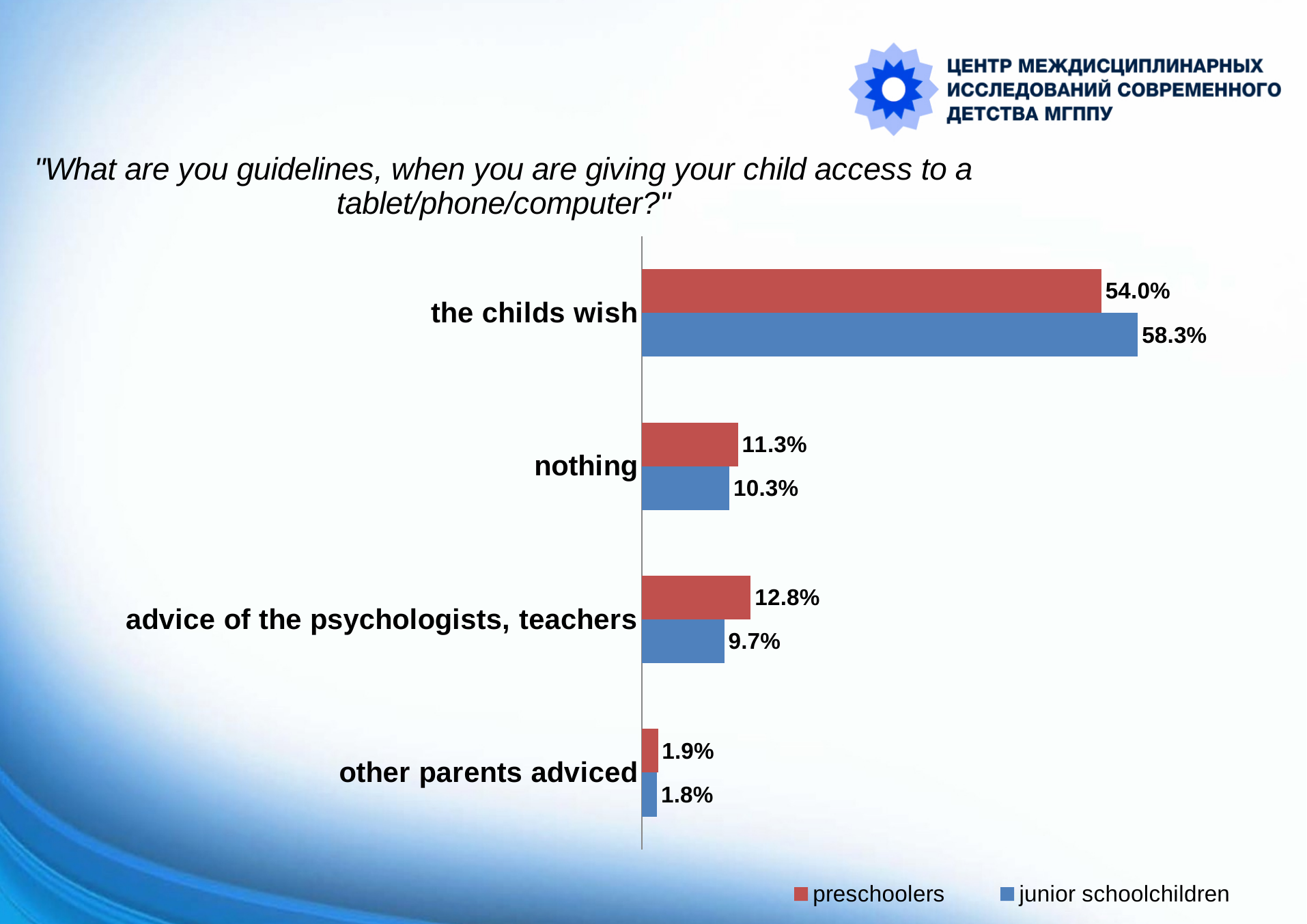
What is the value for junior schoolchildren for "nothing"? 10.3% What is the difference between the junior schoolchildren and preschoolers values for "the childs wish"? 4.3% What kind of chart is shown on the slide? bar chart Which category has the lowest value for preschoolers? other parents adviced What is the difference between the preschoolers and junior schoolchildren values for "advice of the psychologists, teachers"? 3.1% What is the value for junior schoolchildren for "advice of the psychologists, teachers"? 9.7% For "nothing", which series has the larger value, preschoolers or junior schoolchildren? preschoolers How many series does the legend list? 2 What is the value for preschoolers for "other parents adviced"? 1.9% What is the value for preschoolers for "the childs wish"? 54.0% Which category has the highest value for junior schoolchildren? the childs wish How many categories are shown on the chart? 4